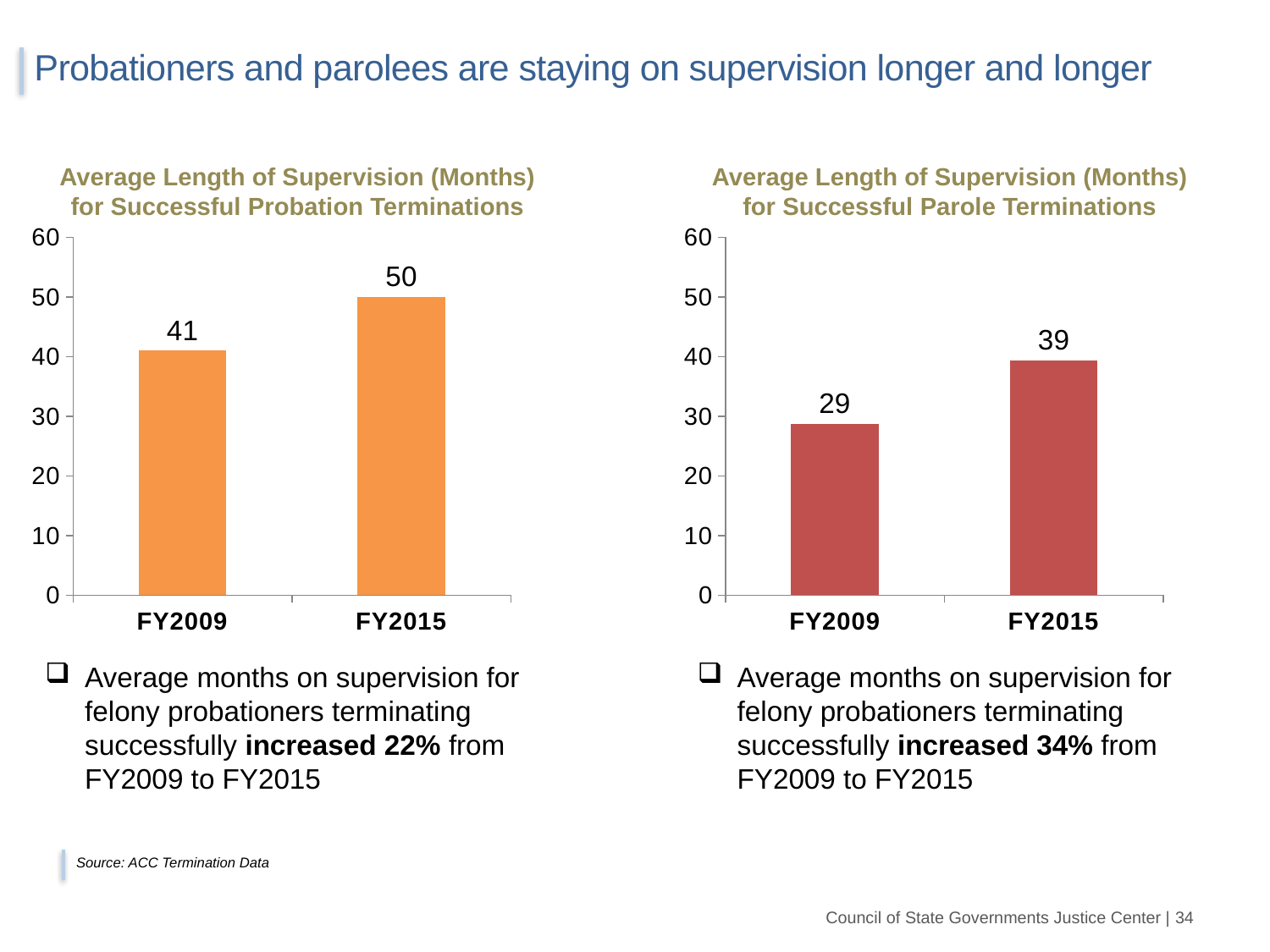
In the 'Average Length of Supervision (Months) for Successful Probation Terminations' chart, do the values rise or fall from FY2009 to FY2015? Rise How many categories are shown on the x axis of the 'Average Length of Supervision (Months) for Successful Probation Terminations' chart? 2 In the 'Average Length of Supervision (Months) for Successful Parole Terminations' chart, what is the value for FY2009? 29 What kind of chart is the 'Average Length of Supervision (Months) for Successful Parole Terminations' chart? Bar chart In the 'Average Length of Supervision (Months) for Successful Parole Terminations' chart, which fiscal year has the higher value? FY2015 In the 'Average Length of Supervision (Months) for Successful Parole Terminations' chart, what is the difference between the FY2015 and FY2009 values? 10 In the 'Average Length of Supervision (Months) for Successful Parole Terminations' chart, is the value for FY2009 greater or less than 30? less In the 'Average Length of Supervision (Months) for Successful Probation Terminations' chart, what is the value for FY2009? 41 In the 'Average Length of Supervision (Months) for Successful Probation Terminations' chart, what is the value for FY2015? 50 In the 'Average Length of Supervision (Months) for Successful Probation Terminations' chart, which fiscal year has the lower value? FY2009 In the 'Average Length of Supervision (Months) for Successful Parole Terminations' chart, what is the value for FY2015? 39 In the 'Average Length of Supervision (Months) for Successful Probation Terminations' chart, what is the difference between the FY2015 and FY2009 values? 9